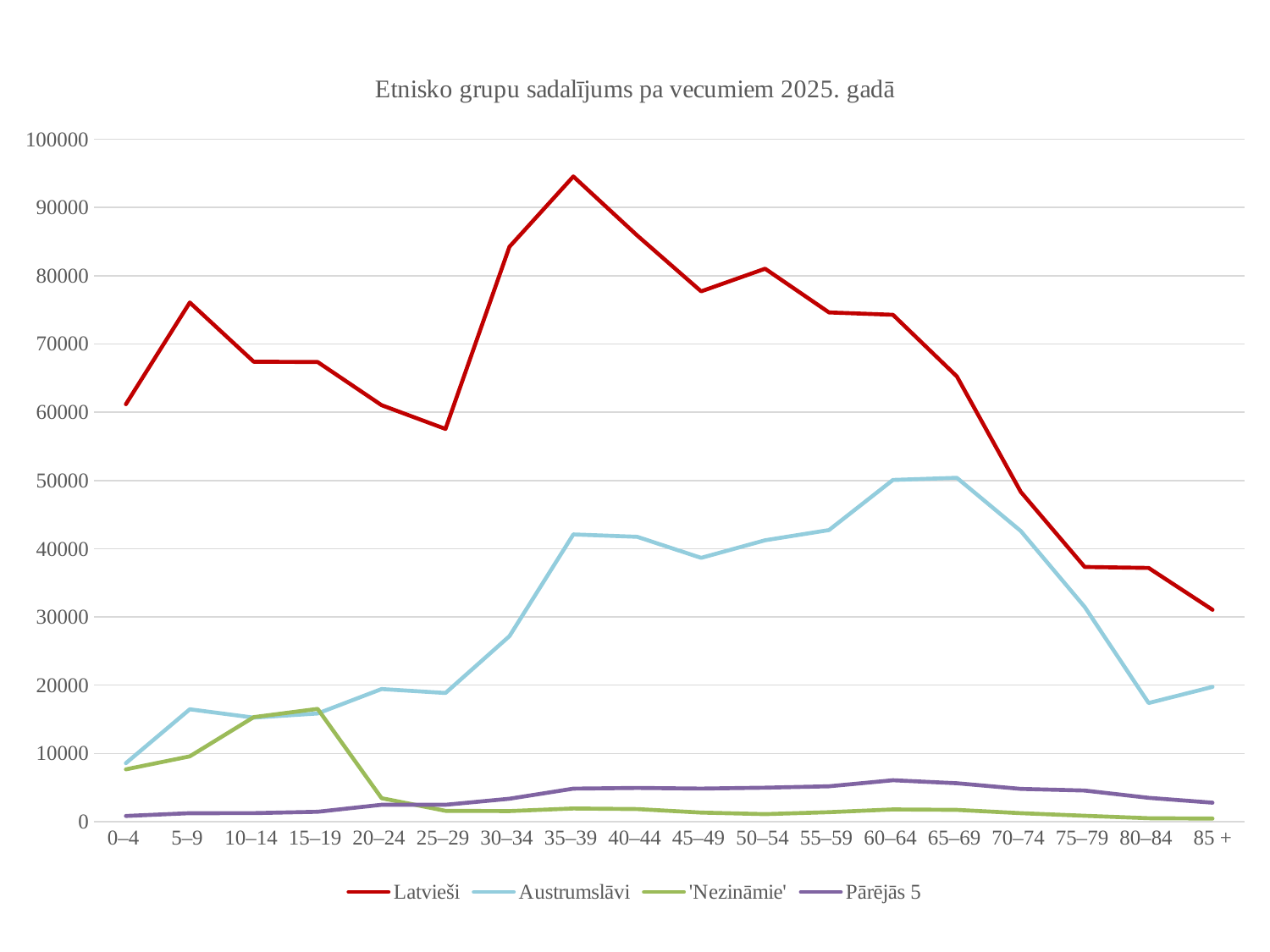
How many series does the legend list? 4 Is the value for Latvieši in the 25–29 age group greater or less than 60000? less In which age group does the 'Nezināmie' series reach its highest value? 15–19 Which series has the larger value in the 20–24 age group, Austrumslāvi or 'Nezināmie'? Austrumslāvi What is the title of the chart? Etnisko grupu sadalījums pa vecumiem 2025. gadā What kind of chart is shown on the slide? line chart How many age groups are shown on the x axis? 18 Is the value for Latvieši in the 35–39 age group greater or less than 90000? greater Is the value for Austrumslāvi in the 80–84 age group greater or less than 20000? less Does the Latvieši series rise or fall overall from the 35–39 age group to the 85 + age group? fall In which age group does the Latvieši series have its lowest value? 85 + In which age group does the Latvieši series reach its highest value? 35–39